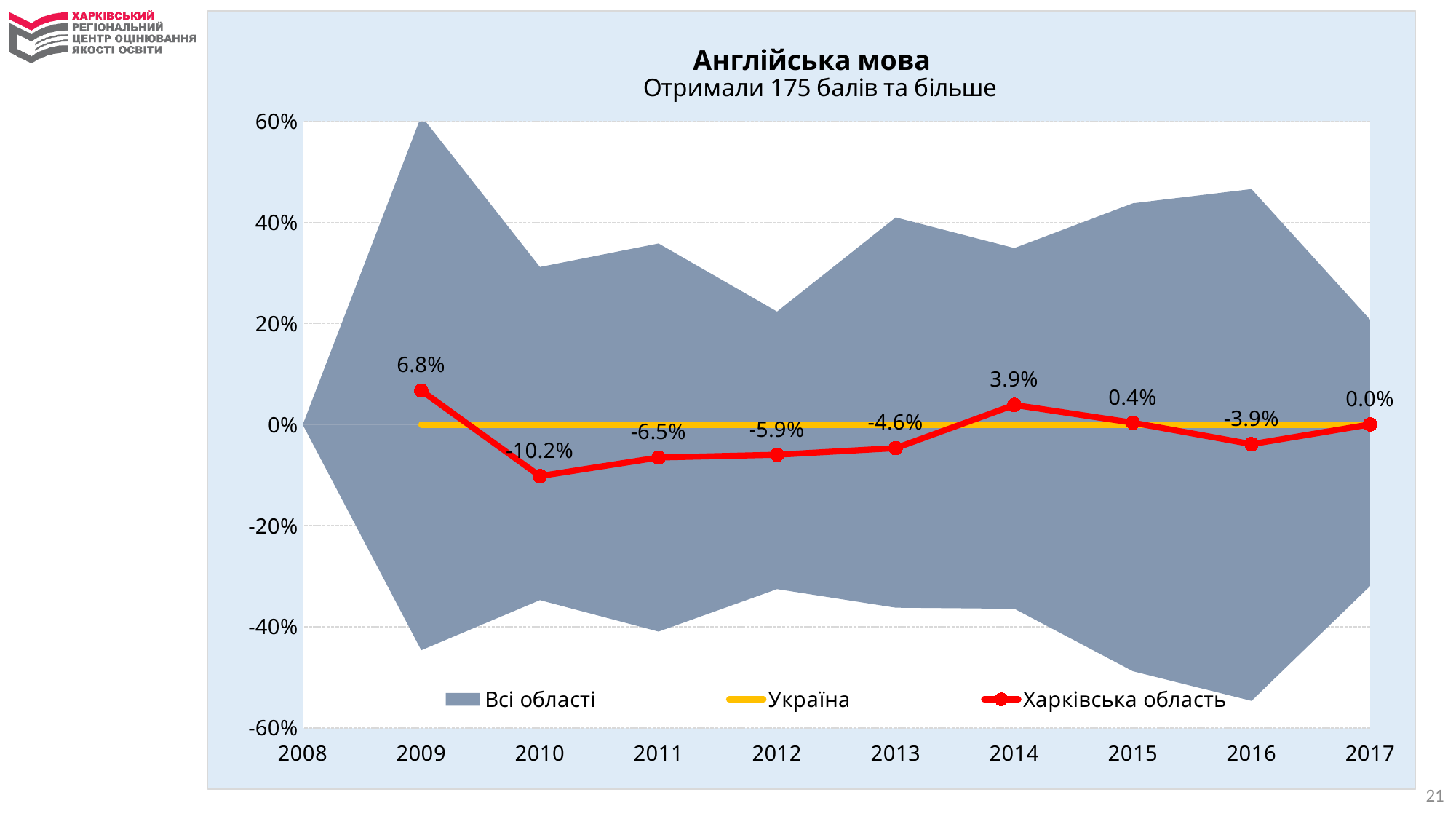
What is the value for Харківська область in 2010? -10.2% Which is larger for Харківська область: the value in 2011 or the value in 2013? 2013 How many series does the legend list? 3 What is the value for Харківська область in 2017? 0.0% What is the value for Харківська область in 2014? 3.9% What kind of chart is this? Line chart with a shaded area band In which year is the value for Харківська область highest? 2009 What is the difference between the Харківська область values in 2009 and 2010? 17.0 percentage points How many years have a labelled data point for Харківська область? 9 Does the Харківська область line rise or fall from 2015 to 2016? fall Is the upper edge of the Всі області band in 2009 greater or less than 40%? greater In which year is the value for Харківська область lowest? 2010